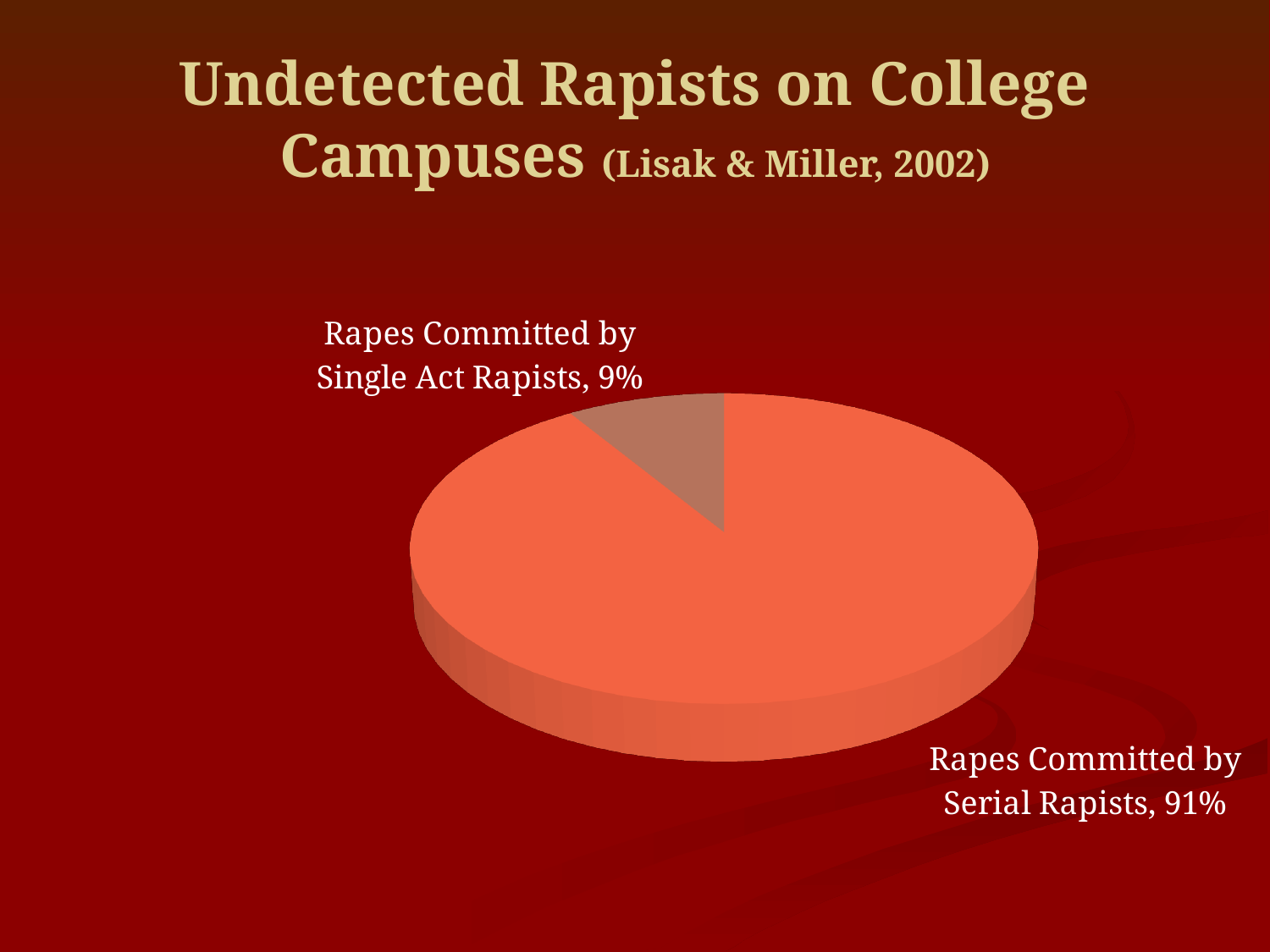
Which is larger: the share of rapes committed by serial rapists or by single act rapists? Rapes Committed by Serial Rapists What kind of chart is shown on the slide? Pie chart Which slice of the pie is the smallest? Rapes Committed by Single Act Rapists What is the difference in percentage points between rapes committed by serial rapists and rapes committed by single act rapists? 82 What percentage of rapes were committed by serial rapists? 91% What is the source cited in the slide title for the pie chart data? Lisak & Miller, 2002 What share of the pie does the Rapes Committed by Serial Rapists slice represent? 91% What percentage of rapes were committed by single act rapists? 9% Which slice of the pie is the largest? Rapes Committed by Serial Rapists What is the title of the slide containing the pie chart? Undetected Rapists on College Campuses (Lisak & Miller, 2002) How many slices does the pie chart have? 2